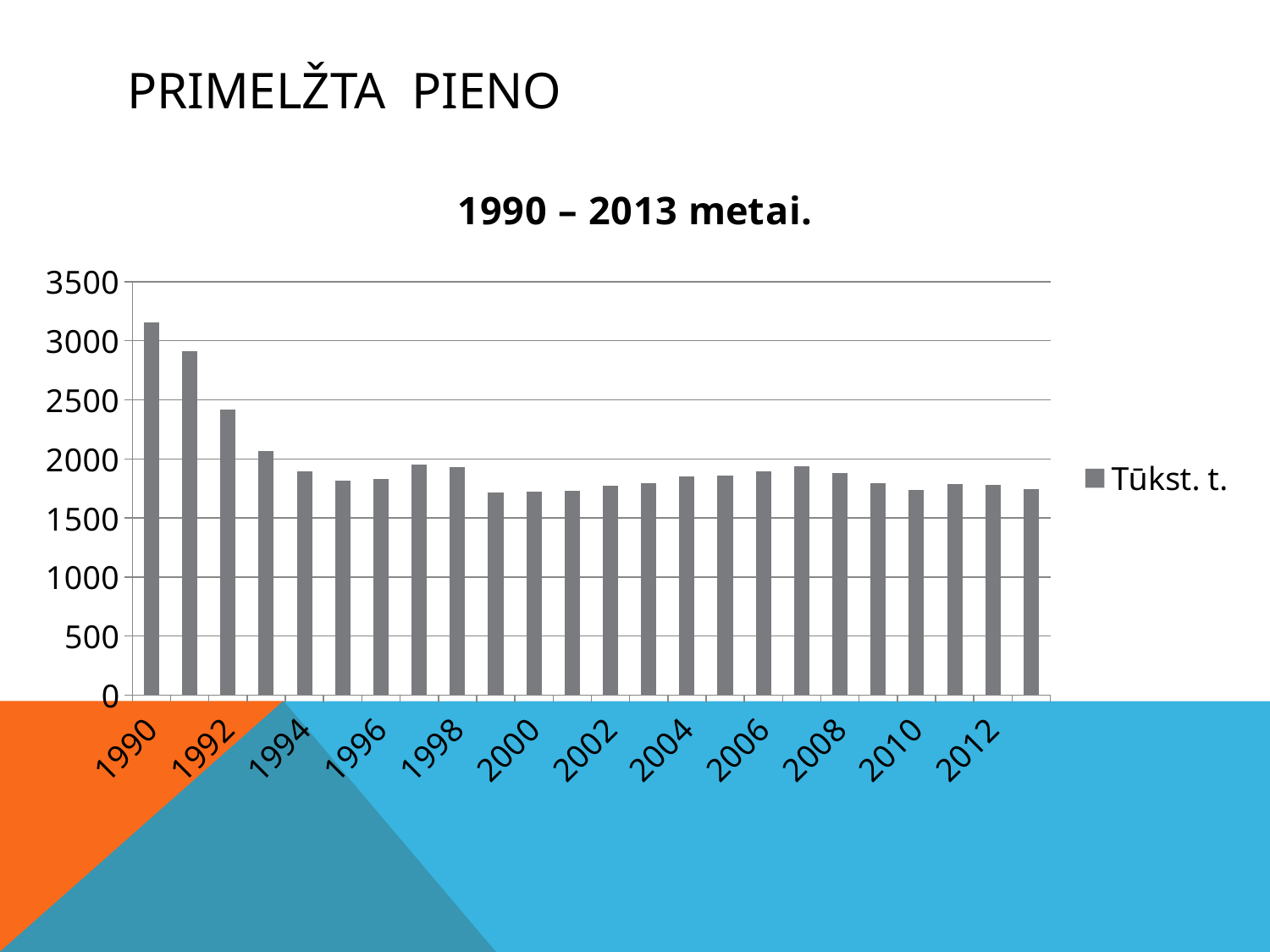
What kind of chart is shown on the slide? bar chart What is the title of the chart? 1990 – 2013 metai. Is the value for 1994 greater or less than 2000? less Is the value for 1990 greater or less than 3000? greater Is the value for 1992 greater or less than 2500? less Do the values rise or fall from 1990 to 1994? fall Which year has the highest value in the chart? 1990 How many bars are plotted in the chart? 24 What is the legend entry for the series in the chart? Tūkst. t. Which is larger, the value for 1990 or the value for 1992? 1990 How many series does the legend list? 1